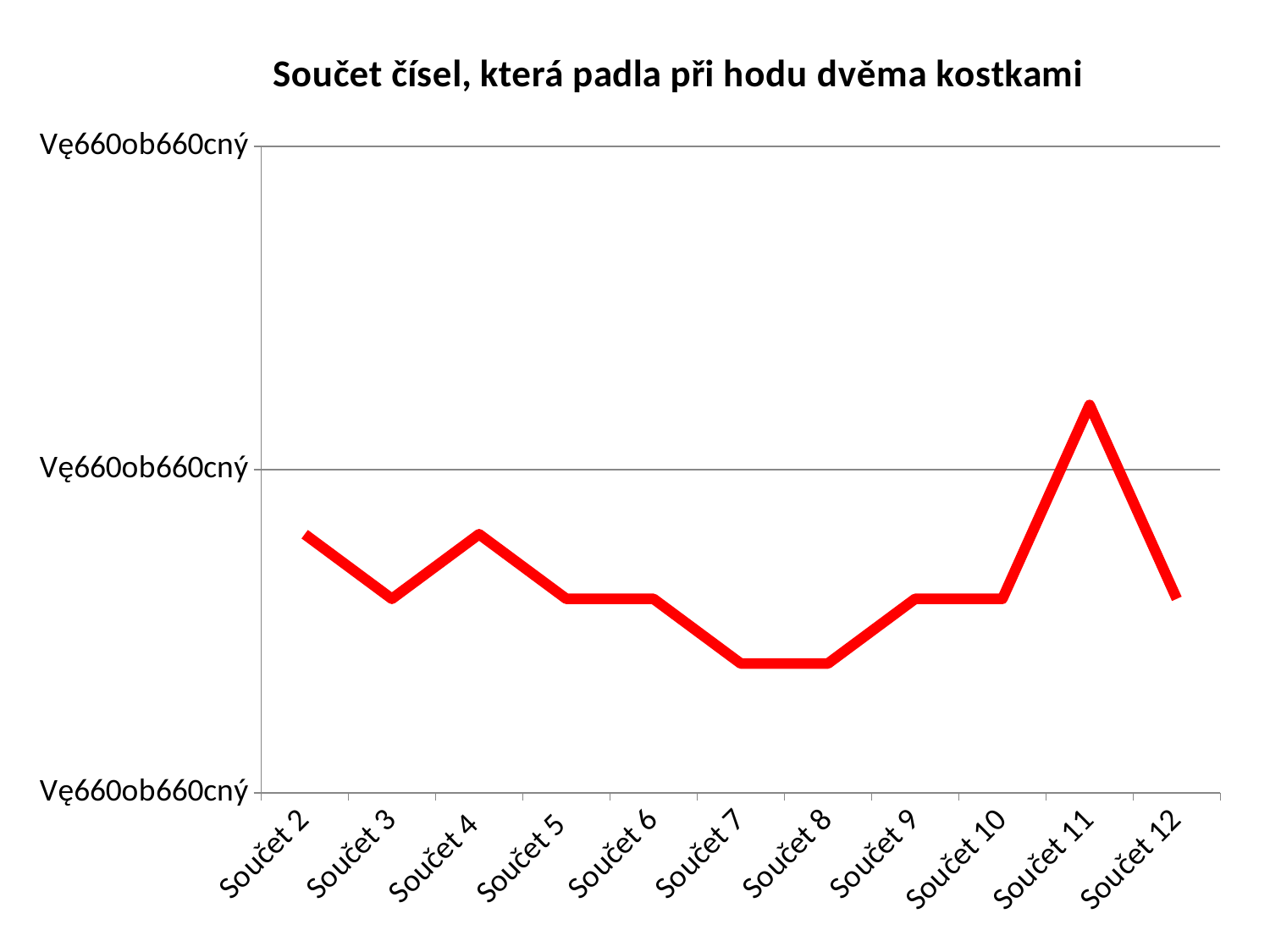
Do the values rise or fall from Součet 4 to Součet 7? fall How many categories are plotted along the x axis? 11 Which is larger, the value for Součet 4 or the value for Součet 5? Součet 4 What colour is the plotted line? red Which is larger, the value for Součet 2 or the value for Součet 3? Součet 2 Which category has the highest value? Součet 11 Which is larger, the value for Součet 10 or the value for Součet 8? Součet 10 What kind of chart is shown on the slide? line chart What is the title of the chart? Součet čísel, která padla při hodu dvěma kostkami Do the values rise or fall from Součet 8 to Součet 11? rise